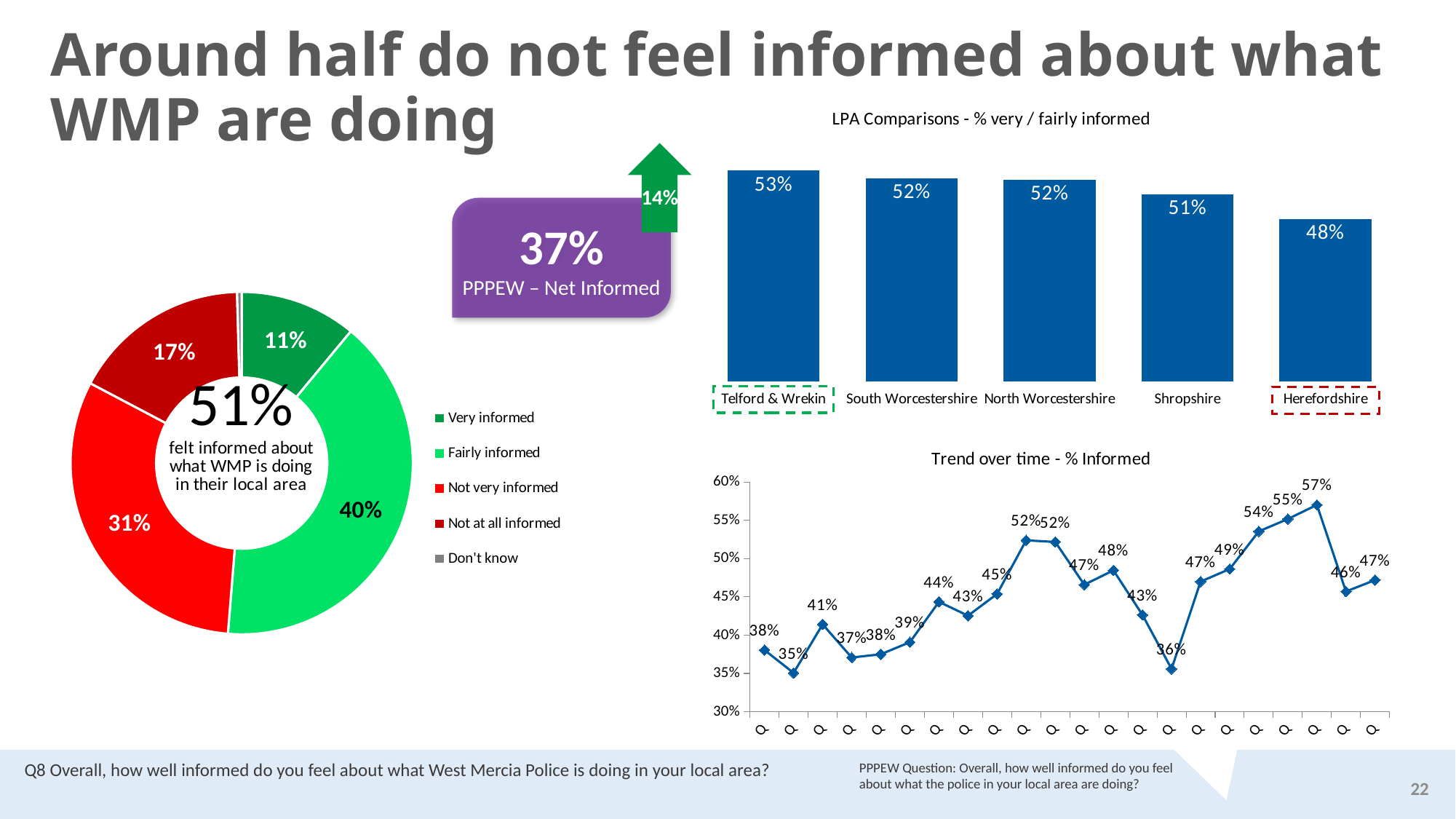
In the 'LPA Comparisons - % very / fairly informed' bar chart, which area has the highest value? Telford & Wrekin What kind of chart is 'Trend over time - % Informed'? Line chart How many areas are shown in the 'LPA Comparisons - % very / fairly informed' bar chart? 5 In the donut chart on the left, which is larger: 'Not very informed' or 'Not at all informed'? Not very informed In the 'Trend over time - % Informed' chart, what is the highest value plotted? 57% In the donut chart on the left, which category has the largest share? Fairly informed In the 'Trend over time - % Informed' chart, what is the lowest value plotted? 35% How many categories does the legend of the donut chart on the left list? 5 In the 'LPA Comparisons - % very / fairly informed' bar chart, what is the difference between Telford & Wrekin and Herefordshire? 5 percentage points In the donut chart on the left, what percentage were 'Fairly informed'? 40% In the 'LPA Comparisons - % very / fairly informed' bar chart, what is the value for Herefordshire? 48% In the 'LPA Comparisons - % very / fairly informed' bar chart, which area has the lowest value? Herefordshire